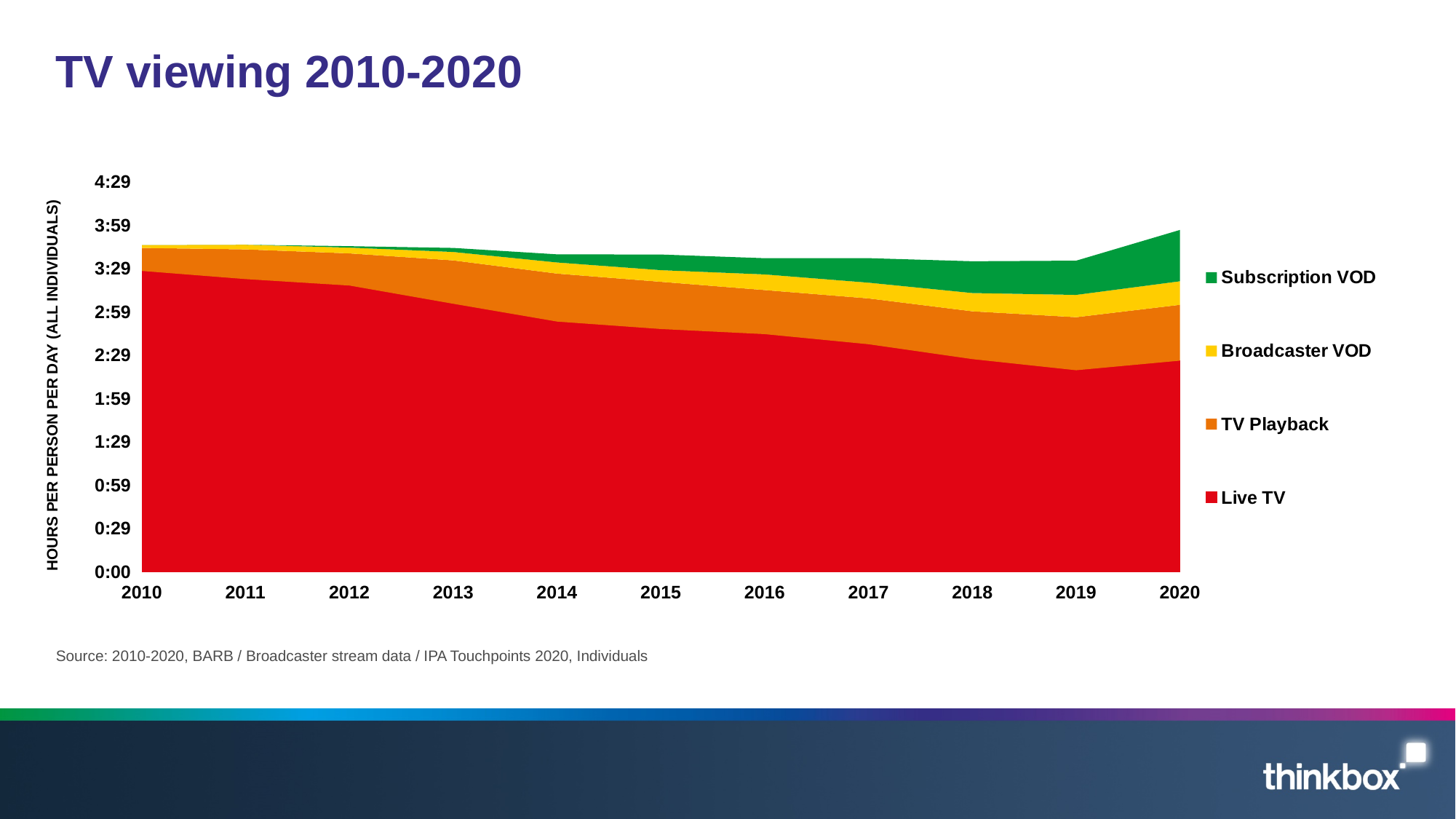
Does Live TV viewing rise or fall between 2010 and 2019? Fall Is the total viewing in 2010 greater or less than 3:29? greater What kind of chart is shown on the slide? Stacked area chart Which series accounts for the largest share of viewing in every year? Live TV Is the Live TV value for 2014 greater or less than 2:59? less What is the label on the y axis? HOURS PER PERSON PER DAY (ALL INDIVIDUALS) How many series does the legend list? 4 Which is larger, Live TV viewing in 2010 or in 2019? 2010 Does Subscription VOD viewing rise or fall between 2013 and 2020? Rise How many years are plotted along the x axis? 11 Is the Live TV value for 2019 greater or less than 2:29? less Which is larger, Subscription VOD viewing in 2020 or in 2012? 2020